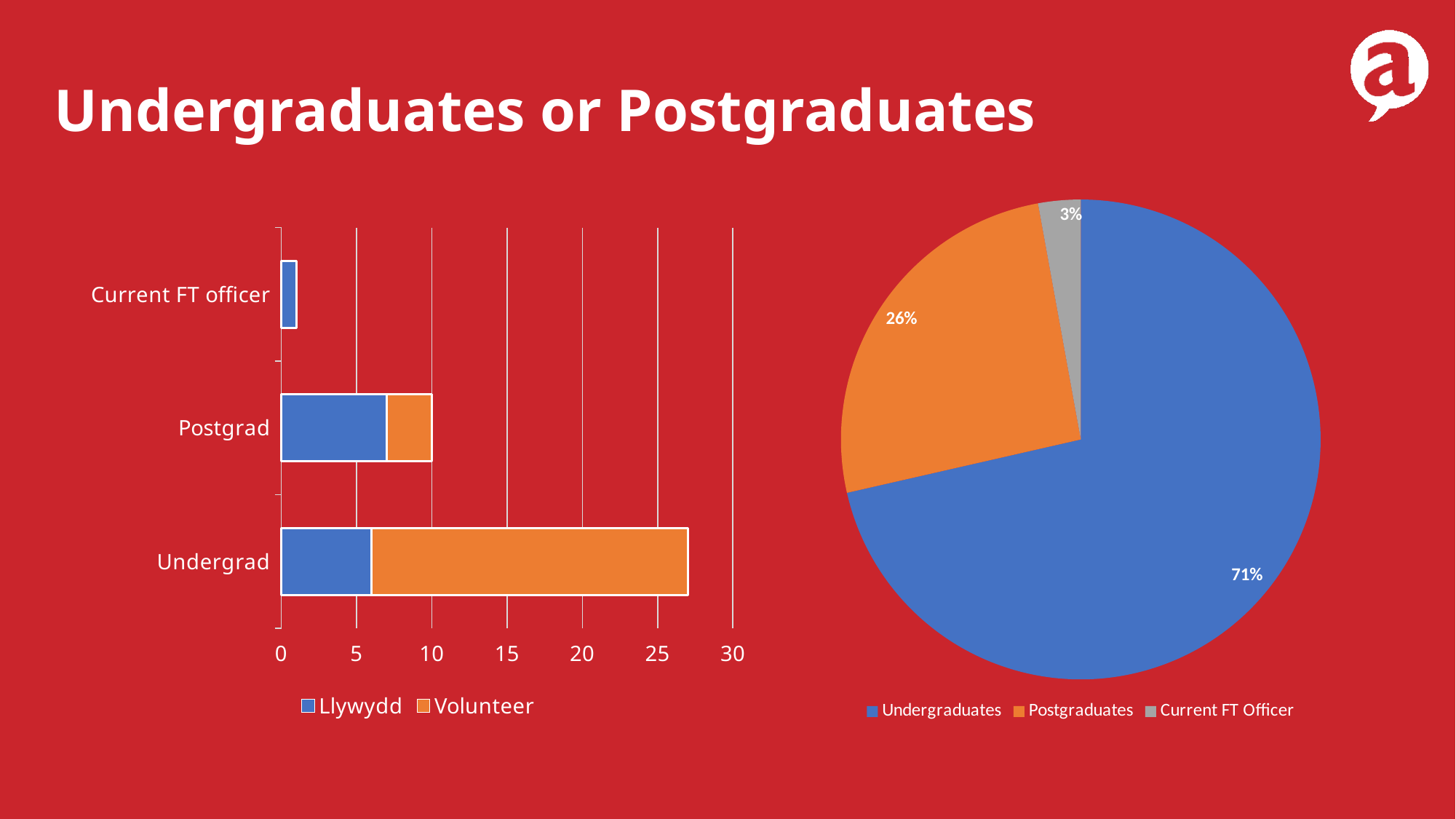
In the pie chart on the right, what is the difference in percentage points between the Undergraduates and Postgraduates slices? 45 In the pie chart on the right, what share is labelled for Current FT Officer? 3% In the pie chart on the right, which slice is the largest? Undergraduates In the pie chart on the right, which slice is the smallest? Current FT Officer How many slices does the pie chart on the right have? 3 What kind of chart is the chart on the right of the slide? pie chart In the bar chart on the left, is the total value for Undergrad greater or less than 25? greater In the pie chart on the right, what share is labelled for Undergraduates? 71% In the pie chart on the right, what share is labelled for Postgraduates? 26% What kind of chart is the chart on the left of the slide? bar chart How many series does the legend of the bar chart on the left list? 2 In the bar chart on the left, which category has the longest total bar, Undergrad or Postgrad? Undergrad